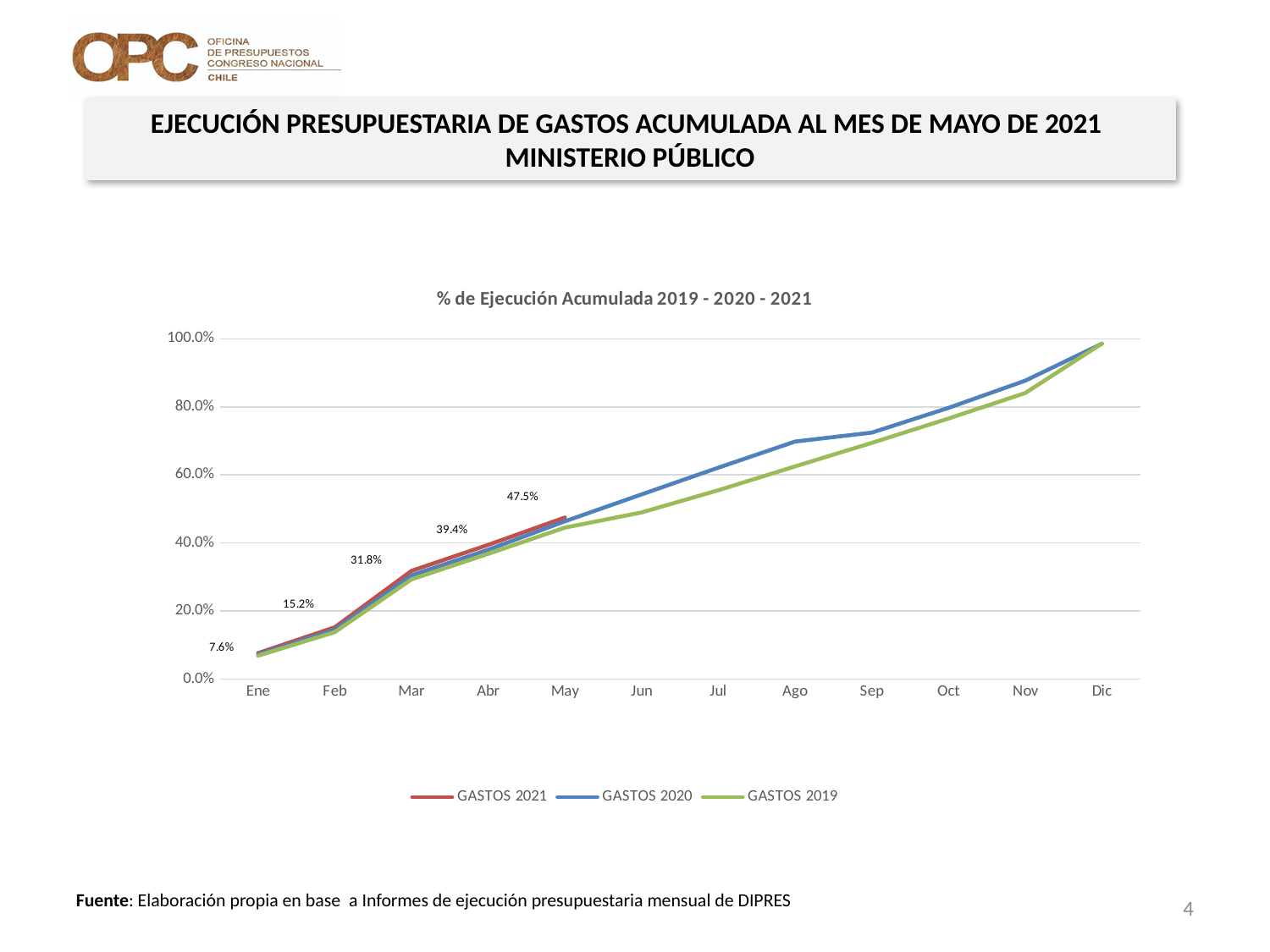
How many months are shown on the x axis? 12 Is the value for GASTOS 2020 in Ago greater or less than 60%? greater Do the GASTOS 2020 values rise or fall from Ene to Dic? rise What is the value of GASTOS 2021 in Ene? 7.6% What is the difference between the GASTOS 2021 values for May and Abr? 8.1% What kind of chart is shown on the slide? line chart In Ago, which series has the larger value, GASTOS 2020 or GASTOS 2019? GASTOS 2020 Among the labelled GASTOS 2021 values, which month has the highest value? May What is the value of GASTOS 2021 in Abr? 39.4% What is the value of GASTOS 2021 in May? 47.5% How many series does the legend list? 3 What is the value of GASTOS 2021 in Mar? 31.8%